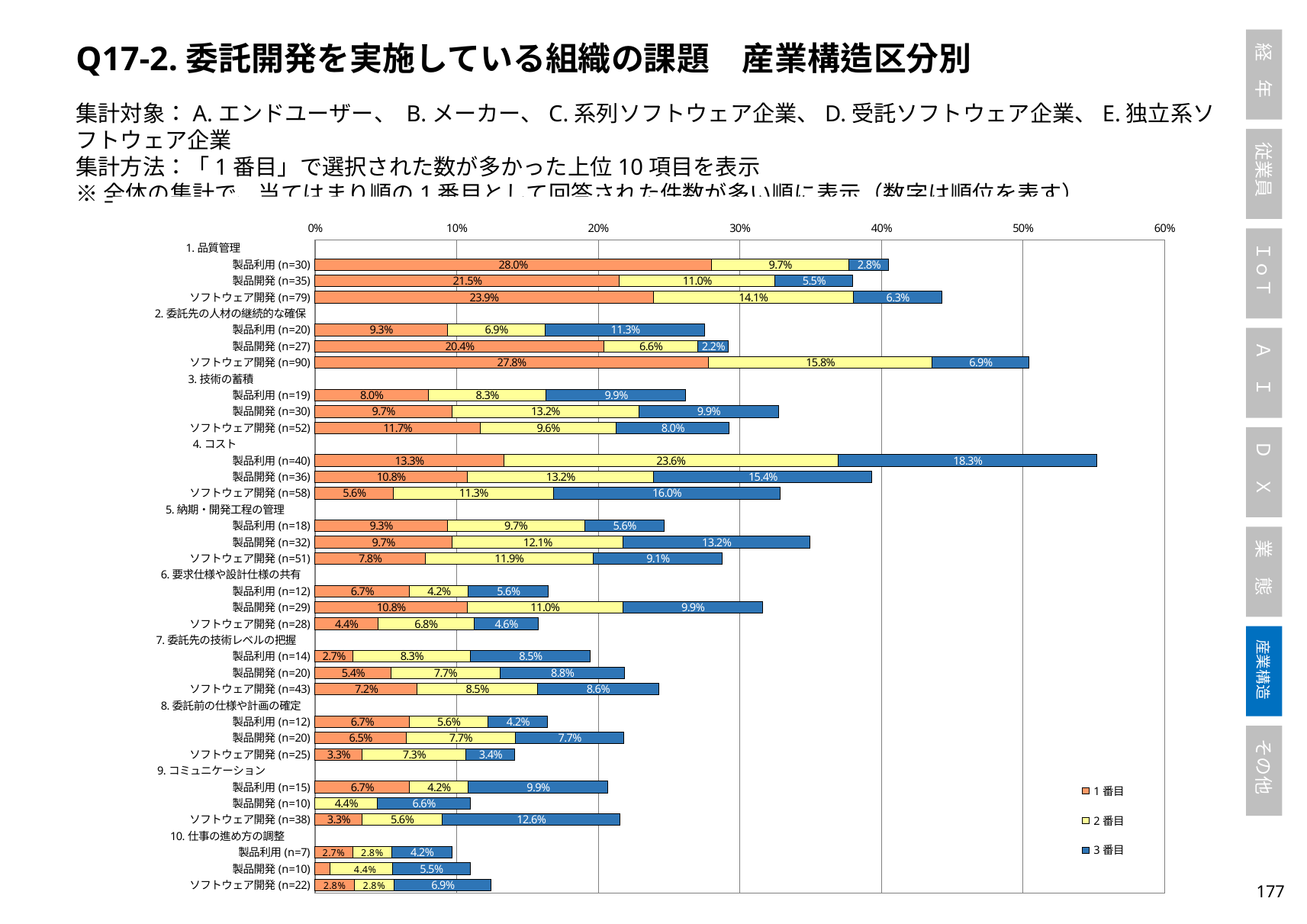
What kind of chart is shown on the slide? Stacked horizontal bar chart What is the 3番目 value for 製品利用 (n=40) under 4. コスト? 18.3% What is the 2番目 value for 製品開発 (n=30) under 3. 技術の蓄積? 13.2% Under 1. 品質管理, which has the larger 1番目 value: 製品利用 (n=30) or 製品開発 (n=35)? 製品利用 (n=30) Under 2. 委託先の人材の継続的な確保, how much larger is the 1番目 value for ソフトウェア開発 (n=90) than for 製品利用 (n=20)? 18.5 percentage points What is the total of the stacked bar for 製品利用 (n=30) under 1. 品質管理? 40.5% Is the total bar length for ソフトウェア開発 (n=79) under 1. 品質管理 greater or less than 40%? greater How many series does the legend list? 3 Which bar has the longest total length in the chart? 製品利用 (n=40) under 4. コスト What is the total of the stacked bar for 製品利用 (n=40) under 4. コスト? 55.2% What is the 3番目 value for ソフトウェア開発 (n=38) under 9. コミュニケーション? 12.6% What is the 1番目 value for 製品利用 (n=30) under 1. 品質管理? 28.0%